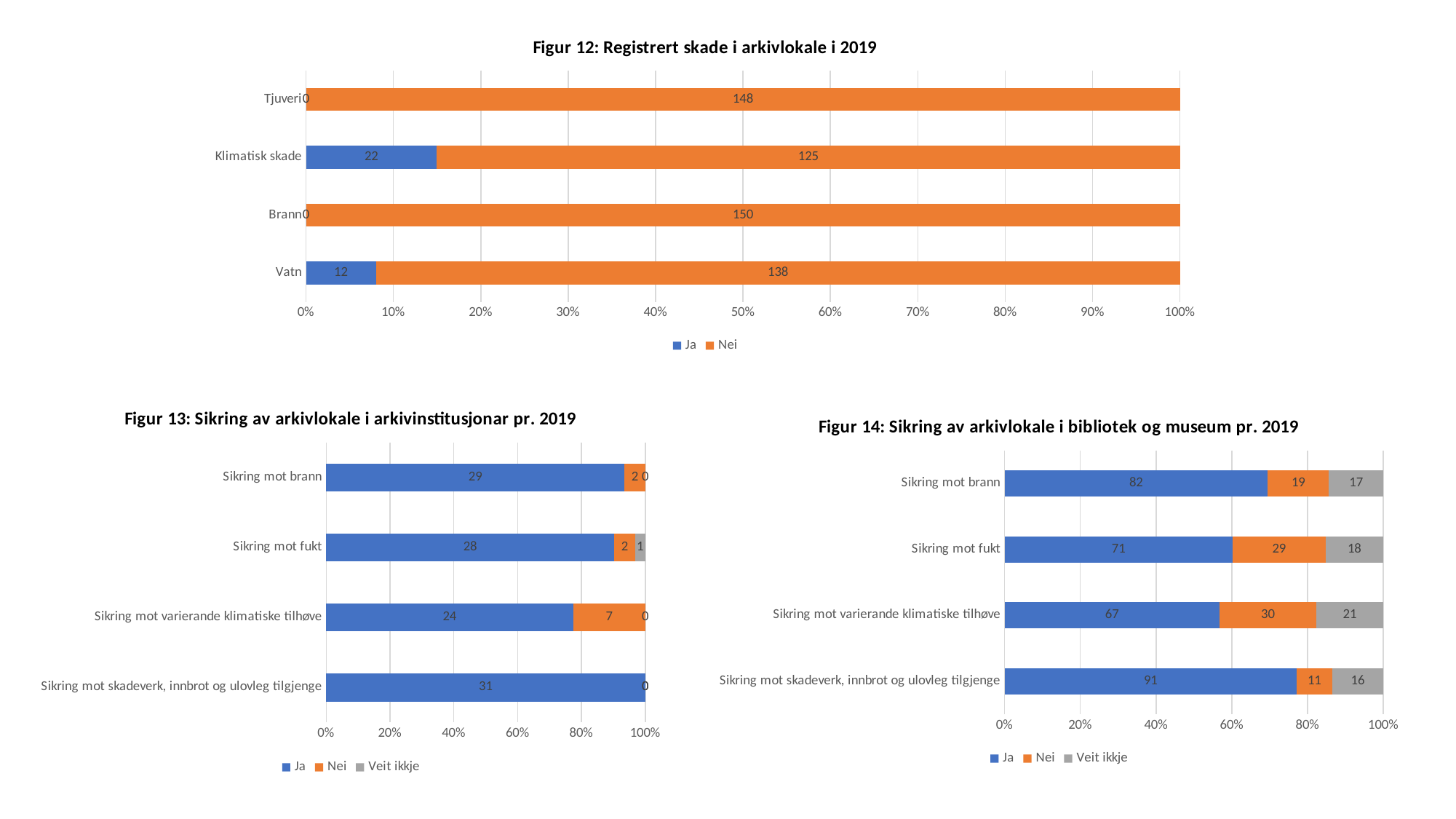
In Figur 13, what is the total of the stacked bar for Sikring mot fukt? 31 In Figur 12, which category has the highest 'Ja' value? Klimatisk skade In Figur 14, what is the 'Veit ikkje' value for Sikring mot varierande klimatiske tilhøve? 21 What kind of chart is Figur 14? Stacked bar chart In Figur 12, what is the 'Ja' value for Klimatisk skade? 22 In Figur 13, which category has the highest 'Nei' value? Sikring mot varierande klimatiske tilhøve In Figur 13, what is the 'Ja' value for Sikring mot varierande klimatiske tilhøve? 24 In Figur 12, what is the difference between the 'Nei' values for Tjuveri and Klimatisk skade? 23 In Figur 14, is the 'Nei' value for Sikring mot fukt larger or smaller than the 'Nei' value for Sikring mot brann? larger In Figur 12, what is the 'Nei' value for Brann? 150 In Figur 12, how many series does the legend list? 2 In Figur 14, which category has the highest 'Ja' value? Sikring mot skadeverk, innbrot og ulovleg tilgjenge